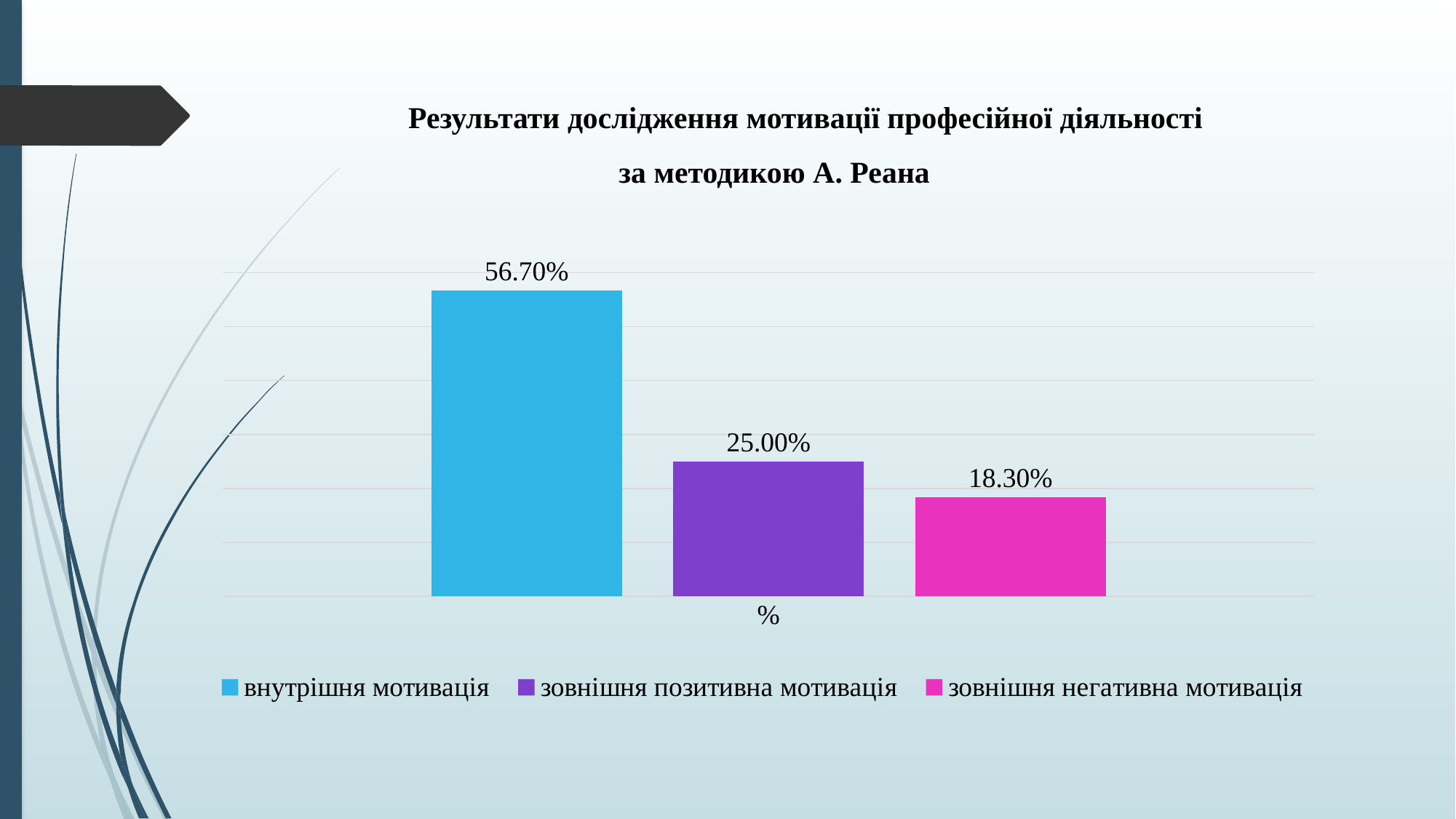
What is the value for зовнішня негативна мотивація? 18.30% What is the difference between the values for зовнішня позитивна мотивація and зовнішня негативна мотивація? 6.70% How many bars are plotted on the chart? 3 What colour is the bar for внутрішня мотивація? blue Which is larger, the value for зовнішня позитивна мотивація or the value for зовнішня негативна мотивація? зовнішня позитивна мотивація What is the difference between the values for внутрішня мотивація and зовнішня позитивна мотивація? 31.70% How many series does the legend list? 3 What is the value for зовнішня позитивна мотивація? 25.00% What is the value for внутрішня мотивація? 56.70% What kind of chart is shown on the slide? bar chart Which series has the lowest value? зовнішня негативна мотивація Which series has the highest value? внутрішня мотивація